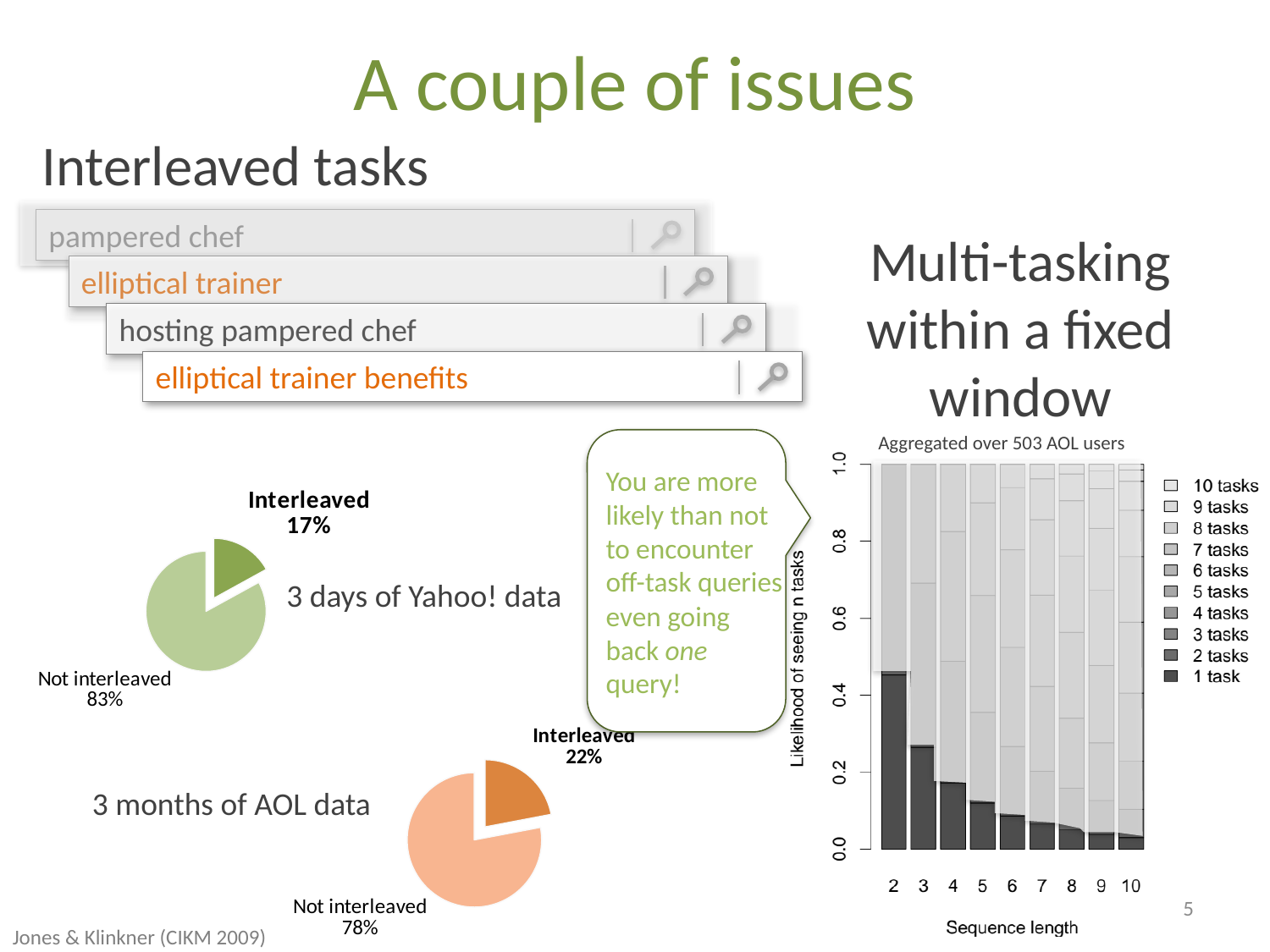
In the 'Likelihood of seeing n tasks' bar chart, is the '1 task' value at sequence length 2 greater or less than 0.4? greater In the pie chart for 3 months of AOL data, what share is Interleaved? 22% What is the difference between the Interleaved share in the AOL pie chart and the Interleaved share in the Yahoo! pie chart? 5% In the 'Likelihood of seeing n tasks' bar chart, does the '1 task' segment rise or fall as sequence length increases? fall In the pie chart for 3 days of Yahoo! data, what share of sessions is Interleaved? 17% In the pie chart for 3 days of Yahoo! data, what share is Not interleaved? 83% What kind of chart is used to show the 3 days of Yahoo! data? pie chart How many series does the legend of the 'Likelihood of seeing n tasks' bar chart list? 10 Comparing the two pie charts, which dataset has the larger Interleaved share, 3 days of Yahoo! data or 3 months of AOL data? 3 months of AOL data How many sequence lengths are shown on the x axis of the 'Likelihood of seeing n tasks' bar chart? 9 In the pie chart for 3 months of AOL data, what share is Not interleaved? 78% What kind of chart is the 'Likelihood of seeing n tasks' chart on the right? stacked bar chart